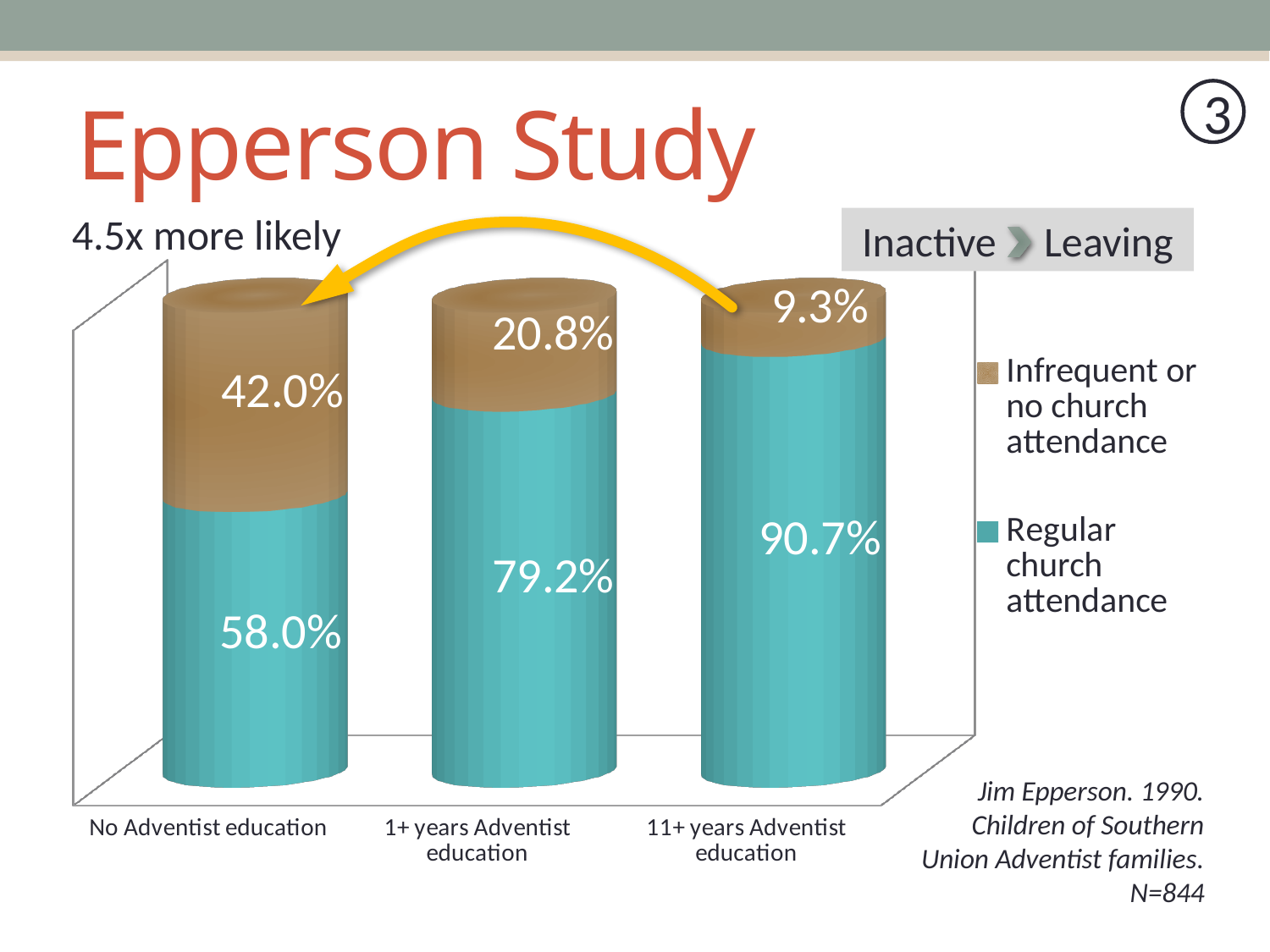
Which is larger: Regular church attendance for 1+ years Adventist education or for 11+ years Adventist education? 11+ years Adventist education What is the value for Regular church attendance for No Adventist education? 58.0% What is the value for Regular church attendance for 11+ years Adventist education? 90.7% What is the difference between the Infrequent or no church attendance values for No Adventist education and 11+ years Adventist education? 32.7% Which category has the highest value for Infrequent or no church attendance? No Adventist education What is the value for Infrequent or no church attendance for 1+ years Adventist education? 20.8% How many series does the legend list? 2 How many categories are shown on the x axis? 3 Does the Regular church attendance value rise or fall from left to right across the categories? Rise What is the value for Infrequent or no church attendance for 11+ years Adventist education? 9.3% What kind of chart is shown? Stacked bar chart Which category has the lowest value for Regular church attendance? No Adventist education